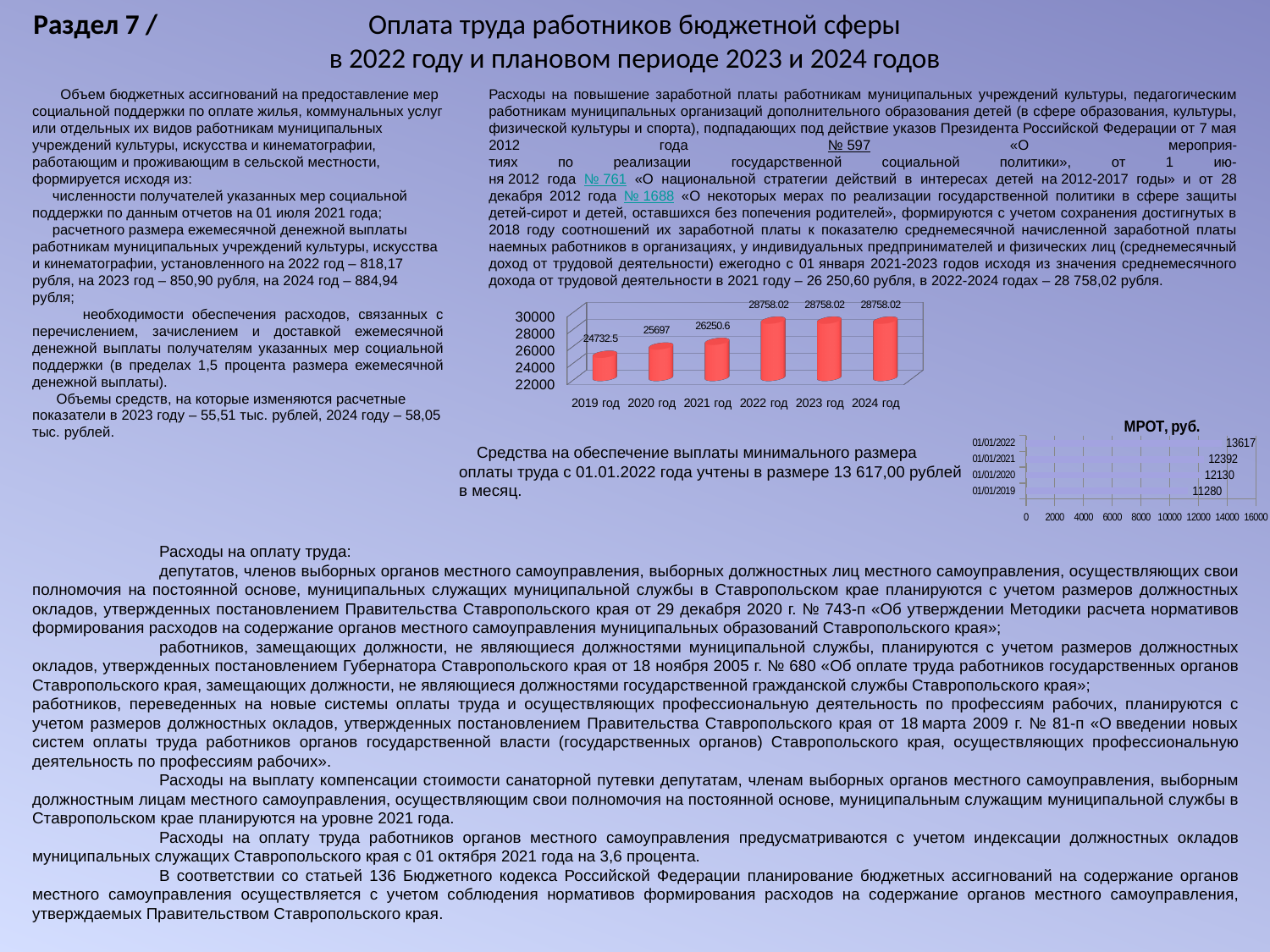
In the bar chart in the middle of the slide (years 2019–2024), how many years are shown on the x axis? 6 In the bar chart in the middle of the slide (years 2019–2024), which year has the lowest value? 2019 год What kind of chart is the chart titled 'МРОТ, руб.'? bar chart In the bar chart in the middle of the slide (years 2019–2024), what is the value for 2019 год? 24732.5 In the chart titled 'МРОТ, руб.', what is the difference between the values for 01/01/2021 and 01/01/2020? 262 In the bar chart in the middle of the slide (years 2019–2024), what is the difference between the values for 2020 год and 2019 год? 964.5 In the chart titled 'МРОТ, руб.', which date has the highest value? 01/01/2022 In the bar chart in the middle of the slide (years 2019–2024), do the values rise or fall from 2019 to 2022? rise In the chart titled 'МРОТ, руб.', what is the value for 01/01/2022? 13617 In the bar chart in the middle of the slide (years 2019–2024), what is the value for 2021 год? 26250.6 In the bar chart in the middle of the slide (years 2019–2024), what is the value for 2023 год? 28758.02 In the chart titled 'МРОТ, руб.', what is the value for 01/01/2019? 11280